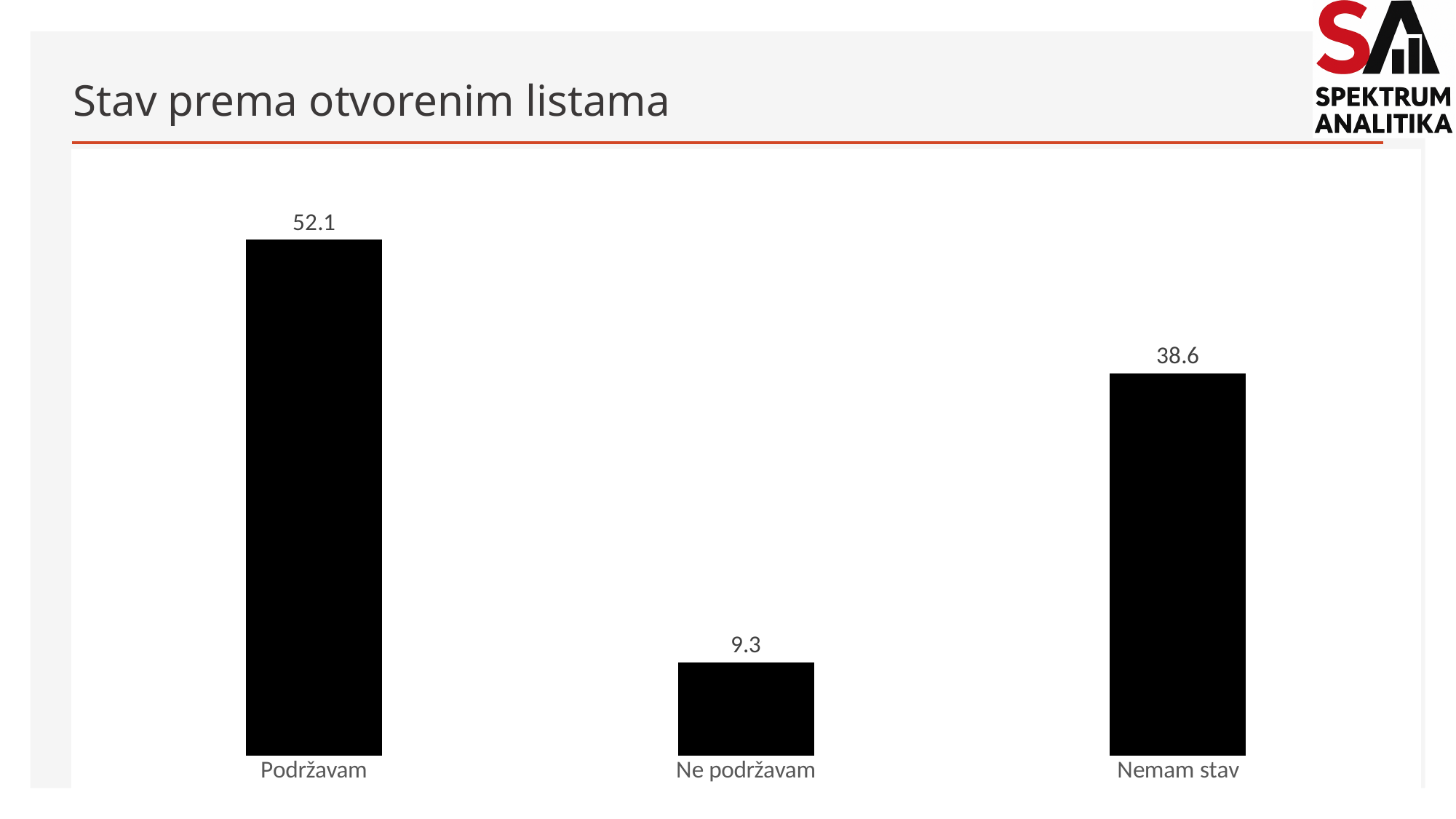
What is the difference between the values for Podržavam and Nemam stav? 13.5 What is the value for Ne podržavam? 9.3 What is the value for Podržavam? 52.1 What is the value for Nemam stav? 38.6 How many categories are shown in the chart? 3 What is the difference between the values for Nemam stav and Ne podržavam? 29.3 Which category has the highest value? Podržavam Which category has the lowest value? Ne podržavam Which is larger, the value for Nemam stav or the value for Ne podržavam? Nemam stav What is the title of the slide? Stav prema otvorenim listama What kind of chart is shown on the slide? Bar chart What colour are the bars in the chart? Black